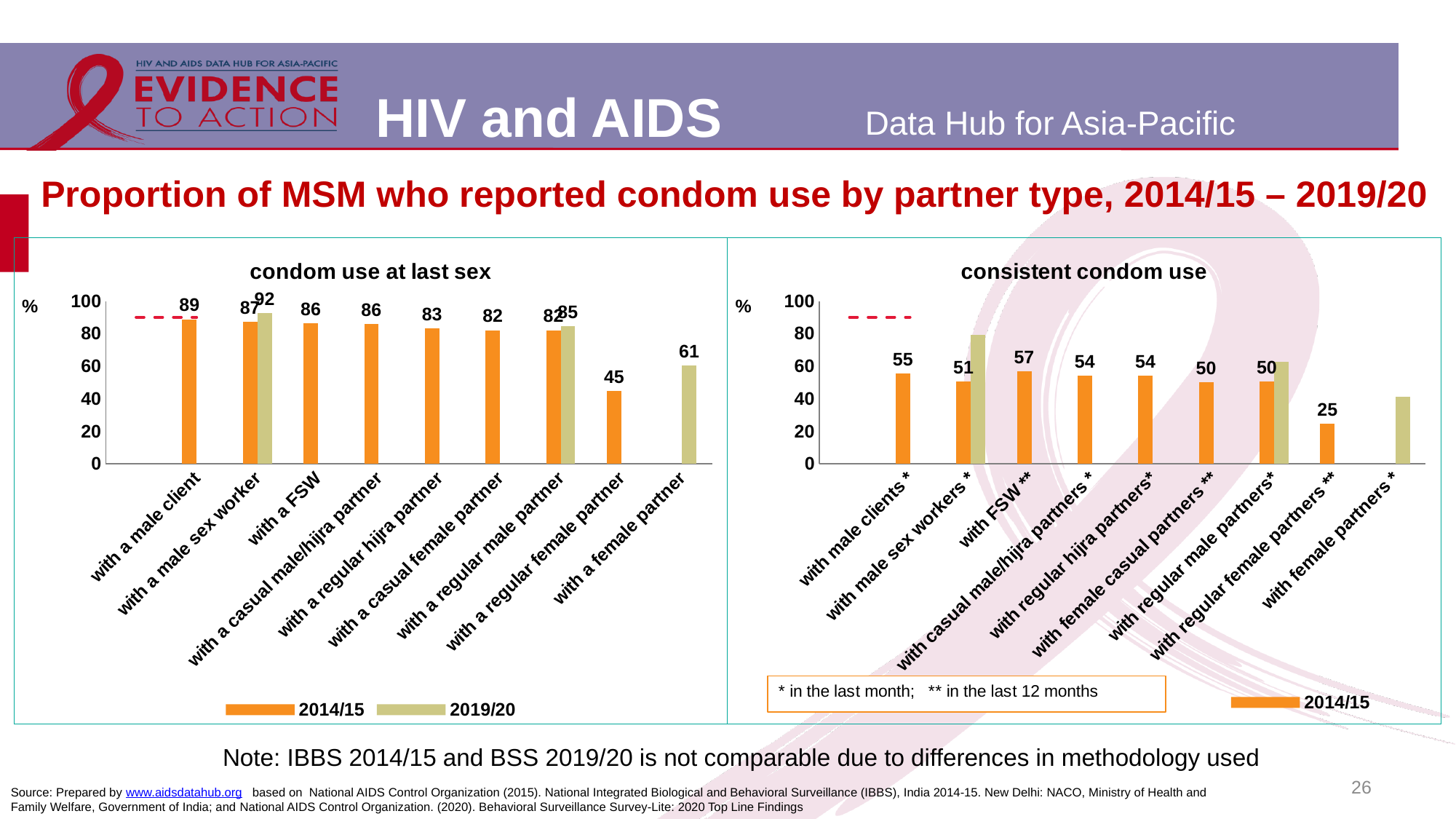
How many partner-type categories are shown on the x axis of the 'consistent condom use' chart? 9 In the 'condom use at last sex' chart, what is the 2019/20 value for 'with a male sex worker'? 92 In the 'condom use at last sex' chart, how much higher is the 2019/20 value than the 2014/15 value for 'with a male sex worker'? 5 In the 'condom use at last sex' chart, what is the 2014/15 value for 'with a male client'? 89 In the 'condom use at last sex' chart, what is the 2019/20 value for 'with a female partner'? 61 In the 'condom use at last sex' chart, which partner type has the lowest 2014/15 value? with a regular female partner In the 'consistent condom use' chart, what is the 2014/15 value for 'with FSW **'? 57 In the 'consistent condom use' chart, what is the 2014/15 value for 'with regular female partners **'? 25 How many series does the legend of the 'condom use at last sex' chart list? 2 In the 'consistent condom use' chart, is the value of the unlabeled bar for 'with female partners *' greater or less than 60? less What type of chart is the 'consistent condom use' chart? bar chart In the 'condom use at last sex' chart, what is the 2014/15 value for 'with a regular female partner'? 45